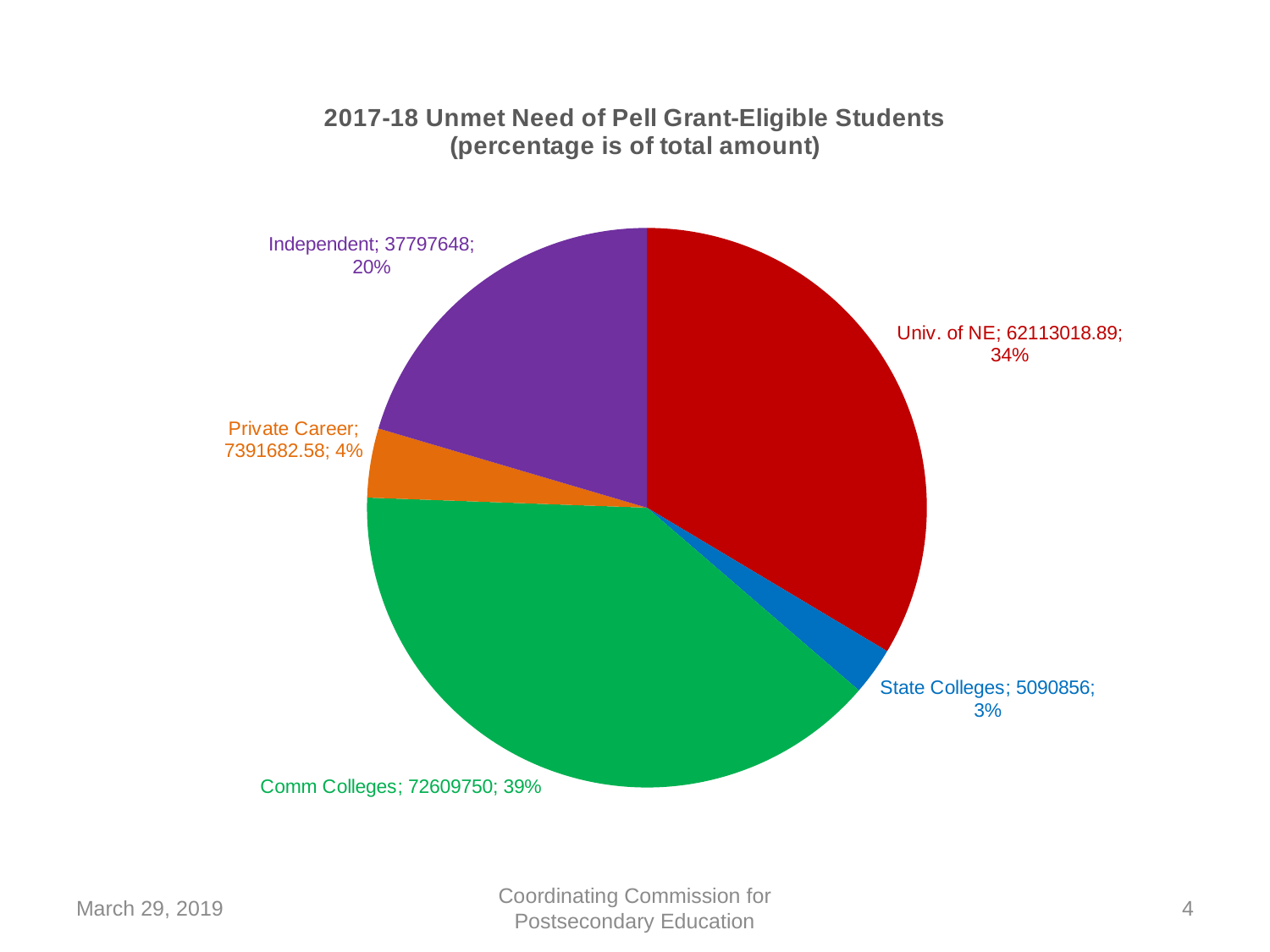
Which is larger, the unmet need for Univ. of NE or for Independent? Univ. of NE Which category has the largest share of unmet need? Comm Colleges What is the unmet need value for Comm Colleges? 72609750 What percentage of the total does Private Career represent? 4% What is the difference between the unmet need for Comm Colleges and Univ. of NE? 10496731.11 What is the title of the chart? 2017-18 Unmet Need of Pell Grant-Eligible Students (percentage is of total amount) Which category has the smallest share of unmet need? State Colleges What is the unmet need value for Univ. of NE? 62113018.89 What is the unmet need value for State Colleges? 5090856 What percentage of the total does Independent represent? 20% How many categories are shown in the pie chart? 5 What type of chart is shown on the slide? Pie chart